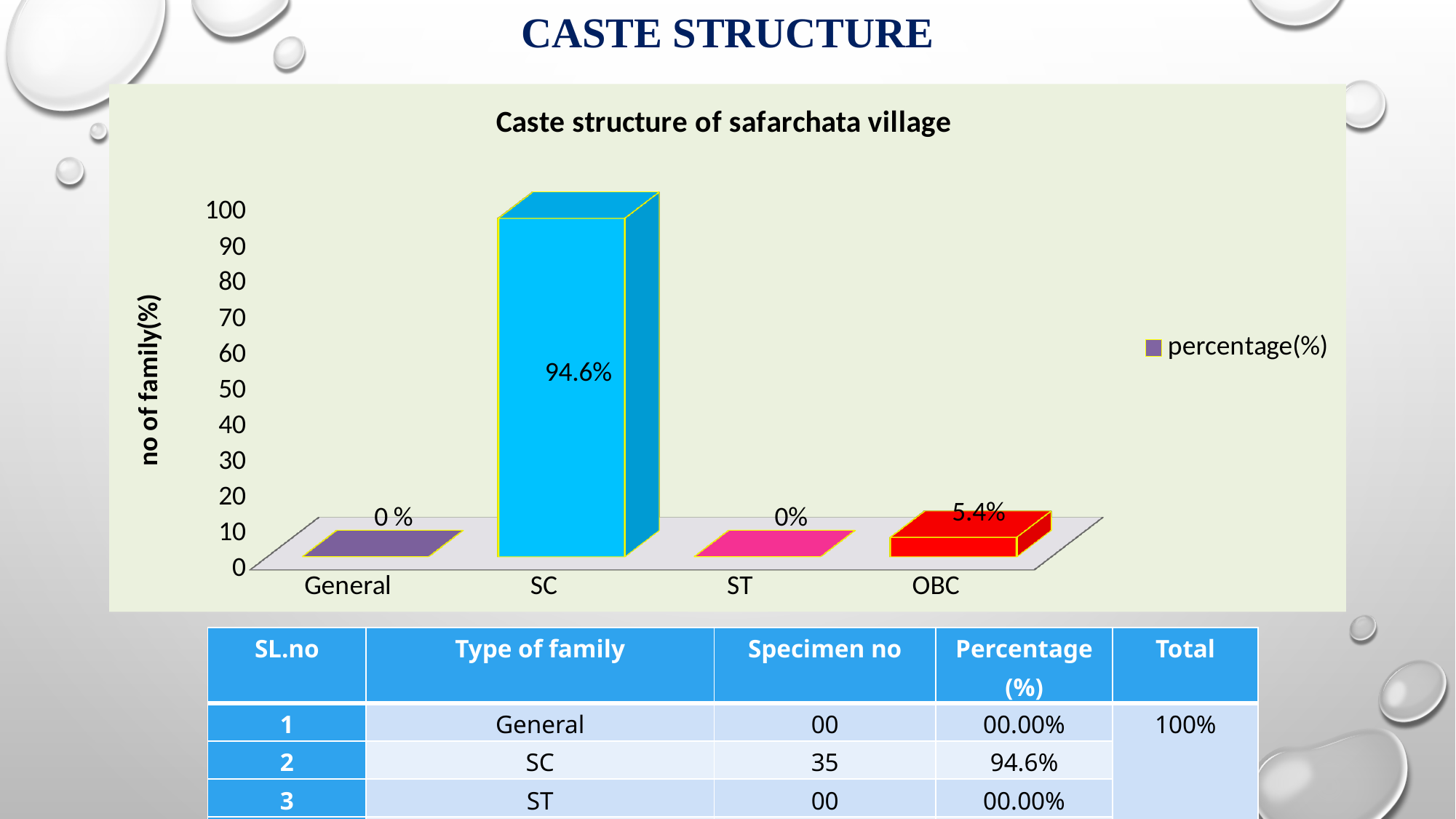
What kind of chart is shown? bar chart Which is larger, the value for OBC or the value for General? OBC What is the title of the chart? Caste structure of safarchata village Is the value for OBC greater or less than 10? less How many series does the legend list? 1 What is the value shown for SC? 94.6% Is the value for SC greater or less than 90? greater How many categories are shown on the x axis? 4 What is the value shown for ST? 0% What is the value shown for OBC? 5.4% Which category has the highest value? SC What is the difference between the values for SC and OBC? 89.2%